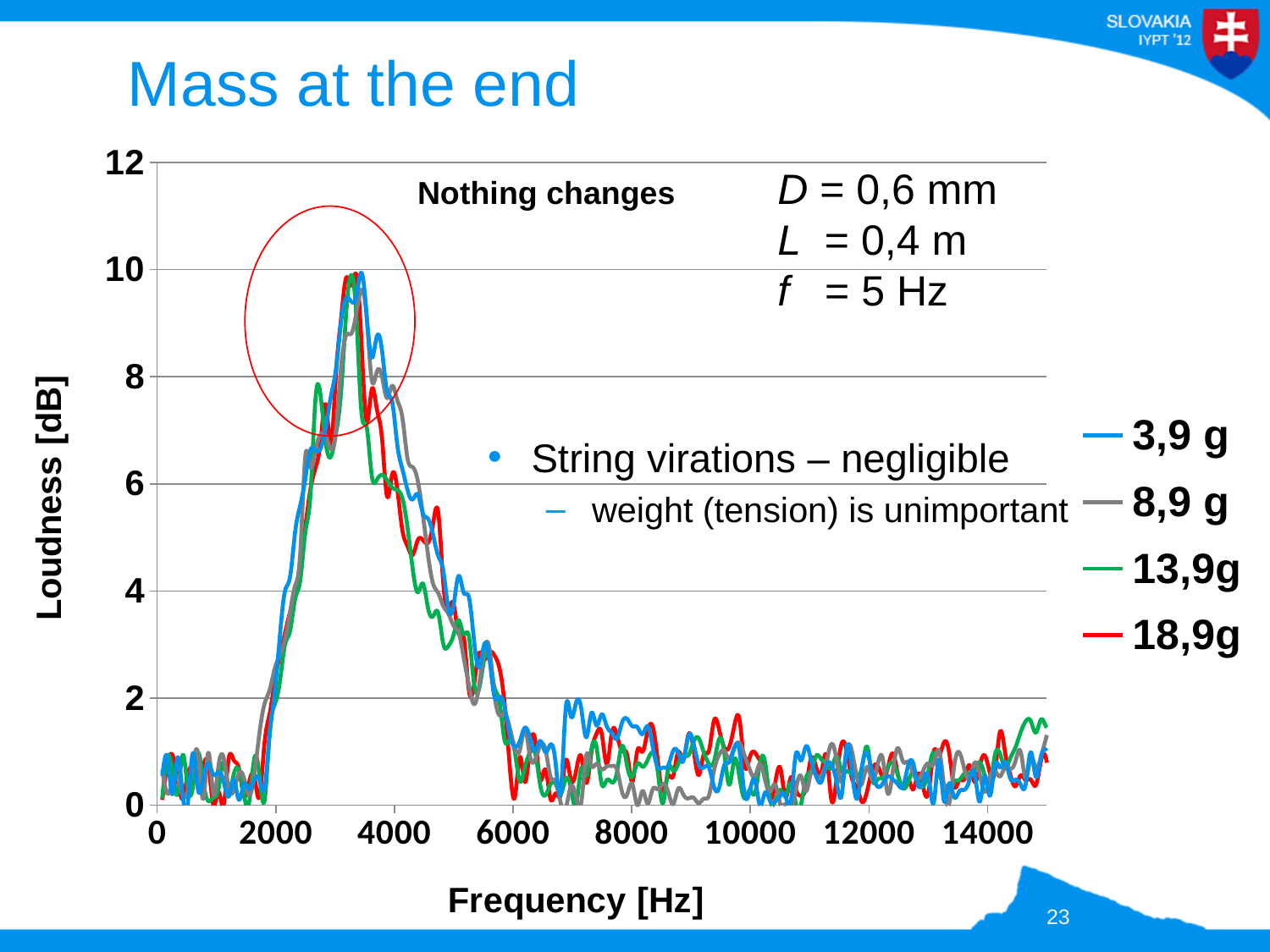
What is the label of the y axis? Loudness [dB] Is the loudness of the 8,9 g series at 12000 Hz greater or less than 2? less Between 2000 Hz and 3000 Hz, does the loudness of the 8,9 g series rise or fall? rise How many series does the legend list? 4 What is the label of the x axis? Frequency [Hz] Is the peak loudness of the 18,9g series greater or less than 12? less Is the loudness of the 18,9g series at 8000 Hz greater or less than 4? less What kind of chart is shown on the slide? line chart